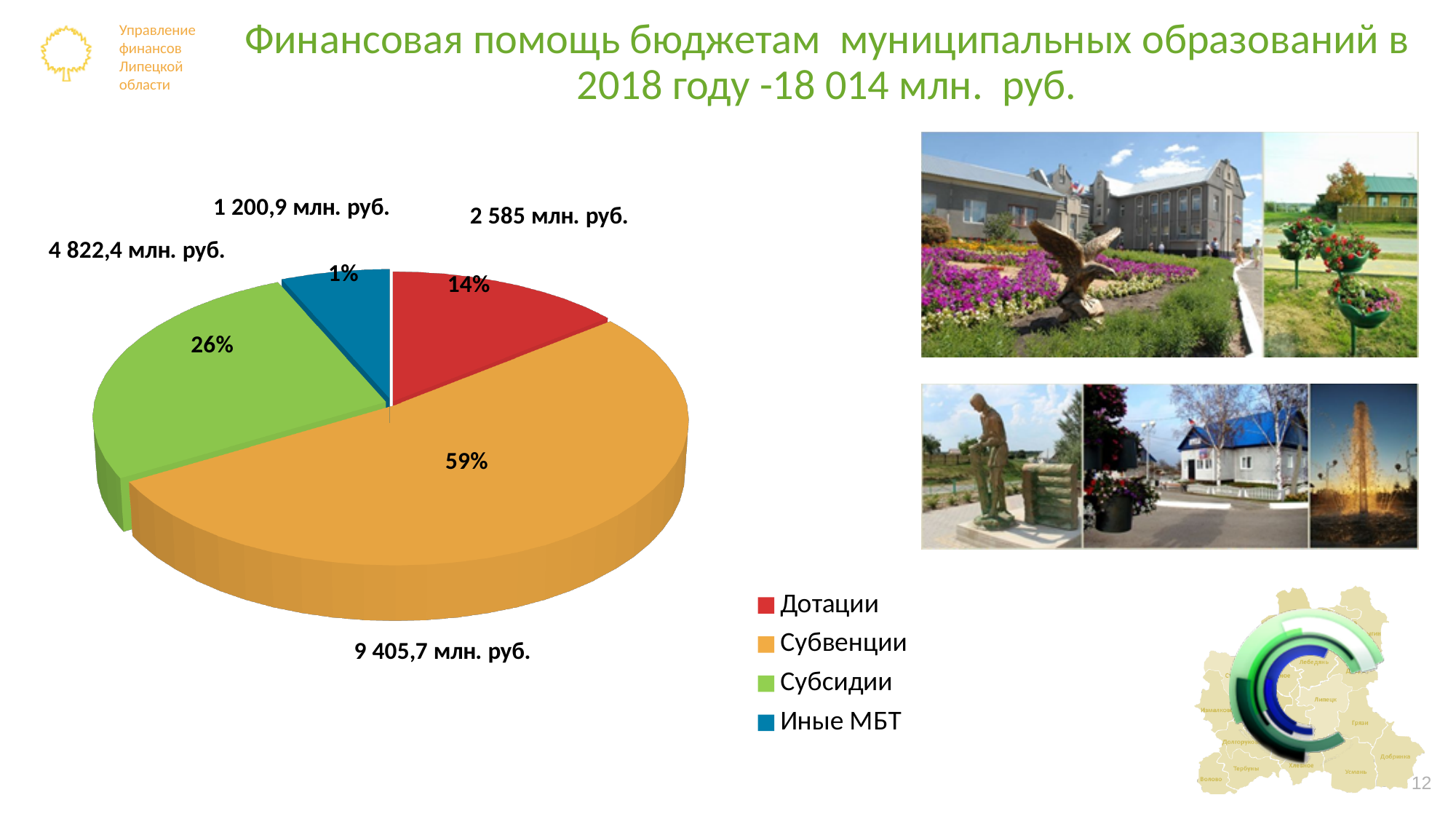
What percentage share of the pie chart is Иные МБТ? 1% What value in млн. руб. is labelled for the Дотации slice? 2 585 млн. руб. What kind of chart is shown on the slide? pie chart How many categories does the legend of the pie chart list? 4 Which slice is larger, Субсидии or Дотации? Субсидии What percentage share of the pie chart is Субвенции? 59% What percentage share of the pie chart is Субсидии? 26% What colour is the Субвенции slice in the pie chart? orange Which category has the largest slice of the pie chart? Субвенции What value in млн. руб. is labelled for the Субвенции slice? 9 405,7 млн. руб. Which category has the smallest slice of the pie chart? Иные МБТ